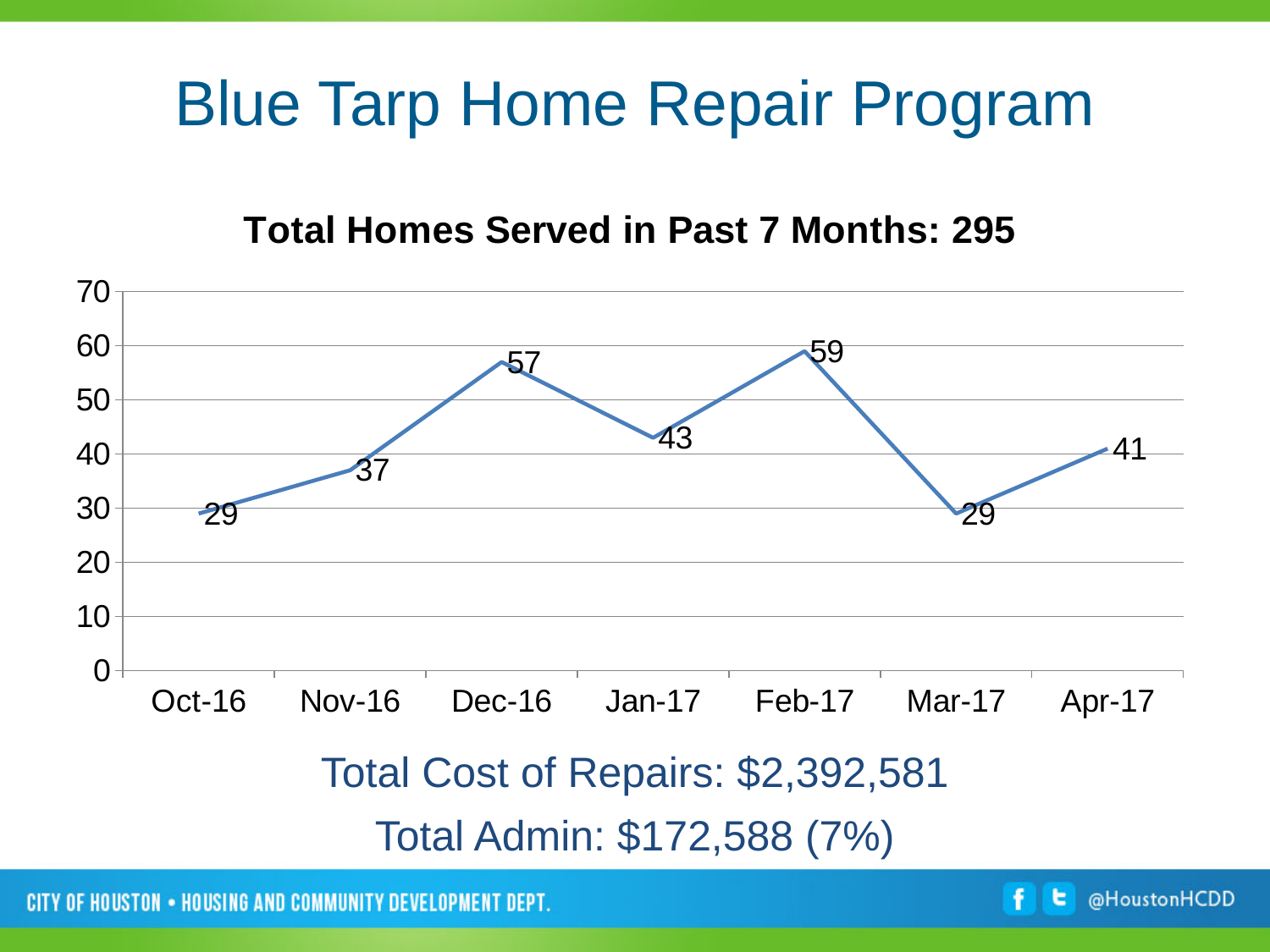
What is the value for Jan-17? 43 What kind of chart is shown? line chart Which is larger, the value for Jan-17 or the value for Apr-17? Jan-17 What is the title of the chart? Total Homes Served in Past 7 Months: 295 How many months are plotted on the chart? 7 Do the values rise or fall from Oct-16 to Dec-16? rise What is the difference between the values for Feb-17 and Mar-17? 30 What is the value for Apr-17? 41 What is the difference between the values for Dec-16 and Nov-16? 20 Which month has the highest value? Feb-17 Is the value for Feb-17 greater or less than 50? greater What is the value for Dec-16? 57